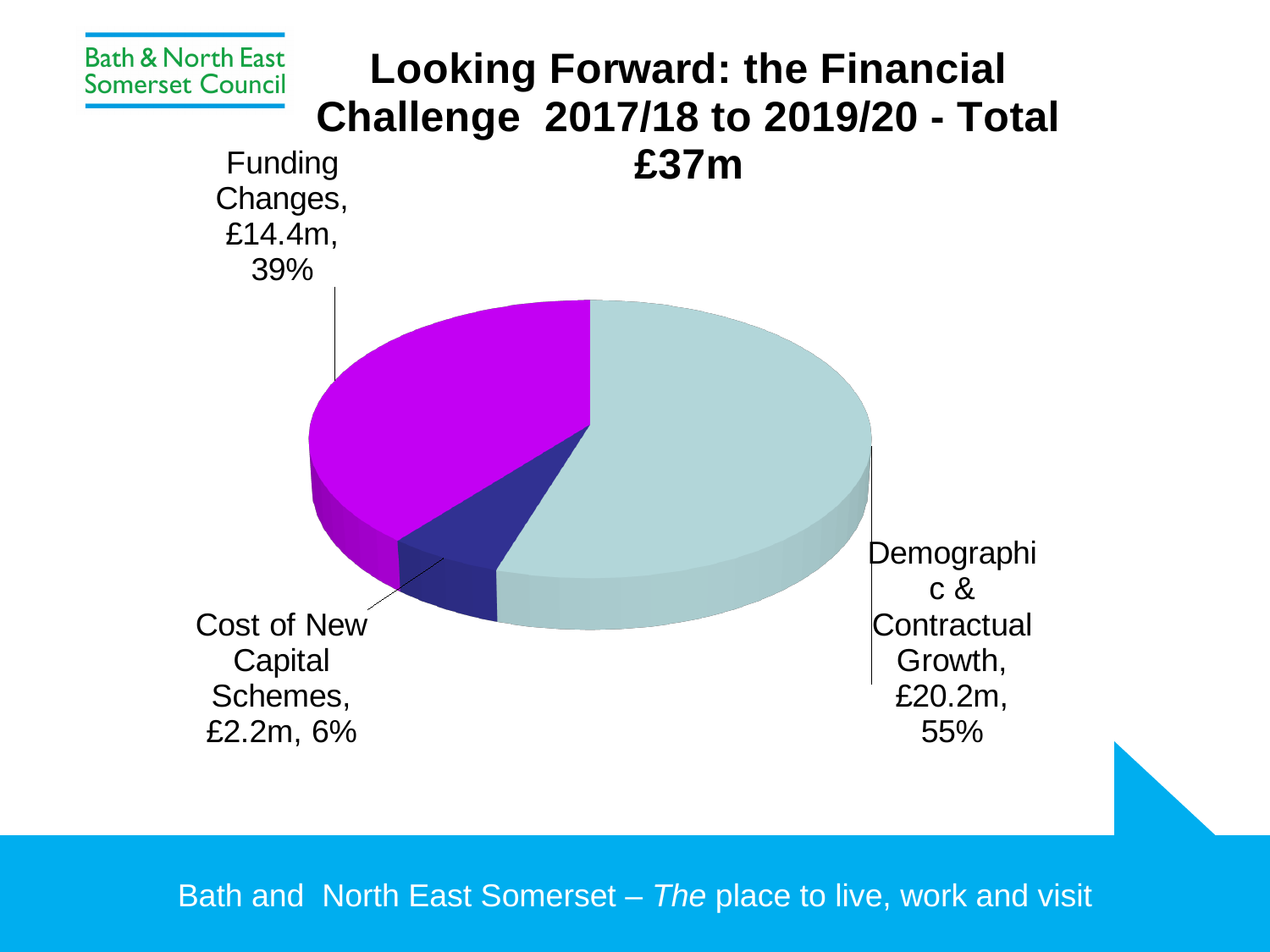
What share of the pie does Funding Changes represent? 39% What share of the pie does Demographic & Contractual Growth represent? 55% What is the value for Cost of New Capital Schemes? £2.2m What share of the pie does Cost of New Capital Schemes represent? 6% Which is larger, Funding Changes or Cost of New Capital Schemes? Funding Changes What is the value for Demographic & Contractual Growth? £20.2m What is the value for Funding Changes? £14.4m What is the difference between the values for Demographic & Contractual Growth and Funding Changes? £5.8m How many slices does the pie chart have? 3 Which category has the smallest slice of the pie? Cost of New Capital Schemes What kind of chart is shown on the slide? pie chart Which category has the largest slice of the pie? Demographic & Contractual Growth